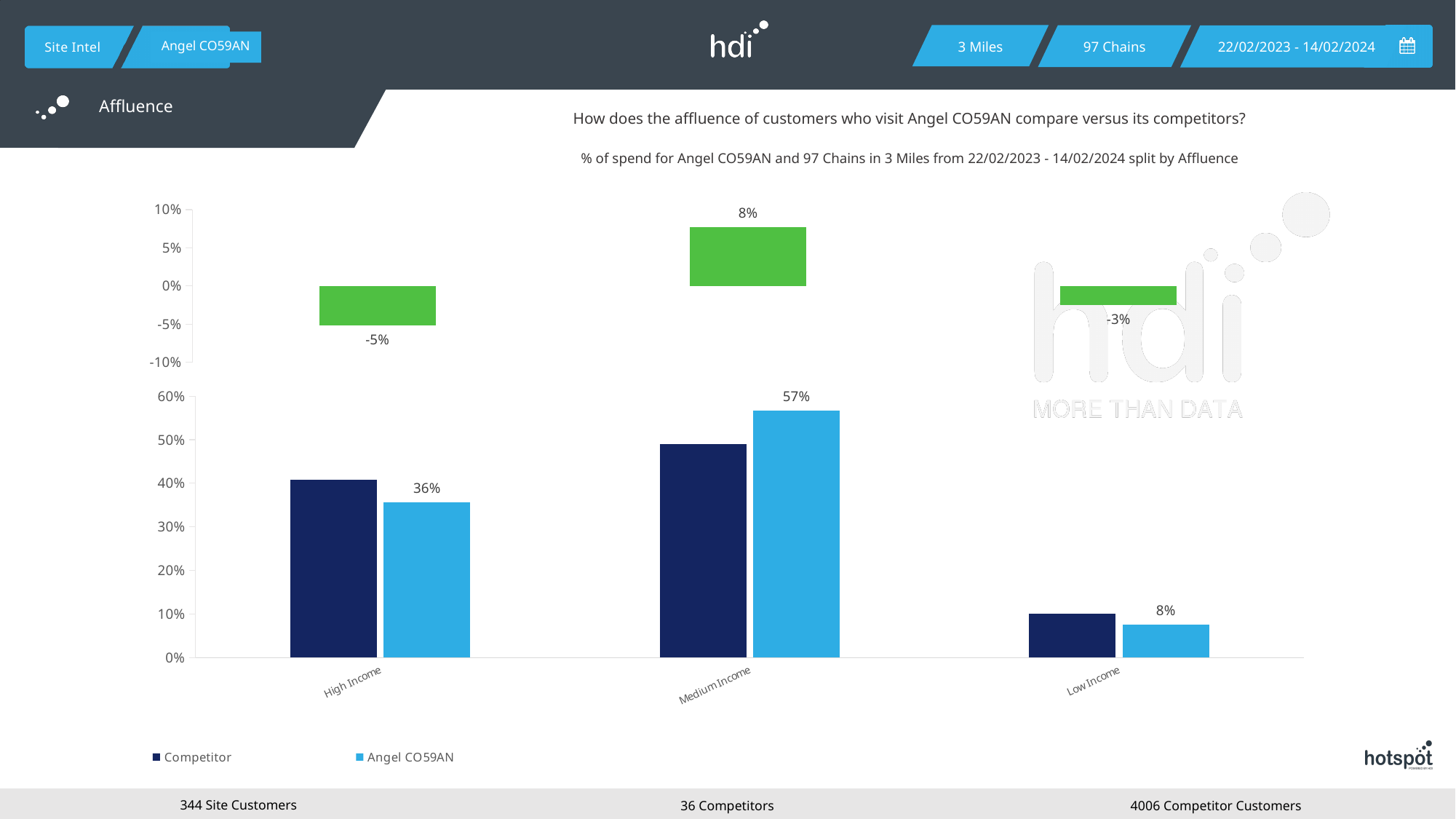
In the bottom bar chart, which is larger for Medium Income: the Competitor bar or the Angel CO59AN bar? Angel CO59AN In the top chart with green bars, what is the value shown for Medium Income? 8% In the bottom bar chart, what is the difference between the Angel CO59AN values for Medium Income and High Income? 21% In the bottom bar chart, what is the value for Angel CO59AN in the High Income category? 36% In the bottom bar chart, which category has the highest value for Angel CO59AN? Medium Income In the bottom bar chart, what is the value for Angel CO59AN in the Low Income category? 8% In the bottom bar chart, which category has the lowest value for Angel CO59AN? Low Income What type of chart is the bottom chart on the slide? Bar chart In the bottom bar chart, is the Competitor value for High Income greater or less than 30%? greater In the top chart with green bars, what is the value shown for High Income? -5% In the bottom bar chart, what is the value for Angel CO59AN in the Medium Income category? 57% How many series does the legend of the bottom bar chart list? 2